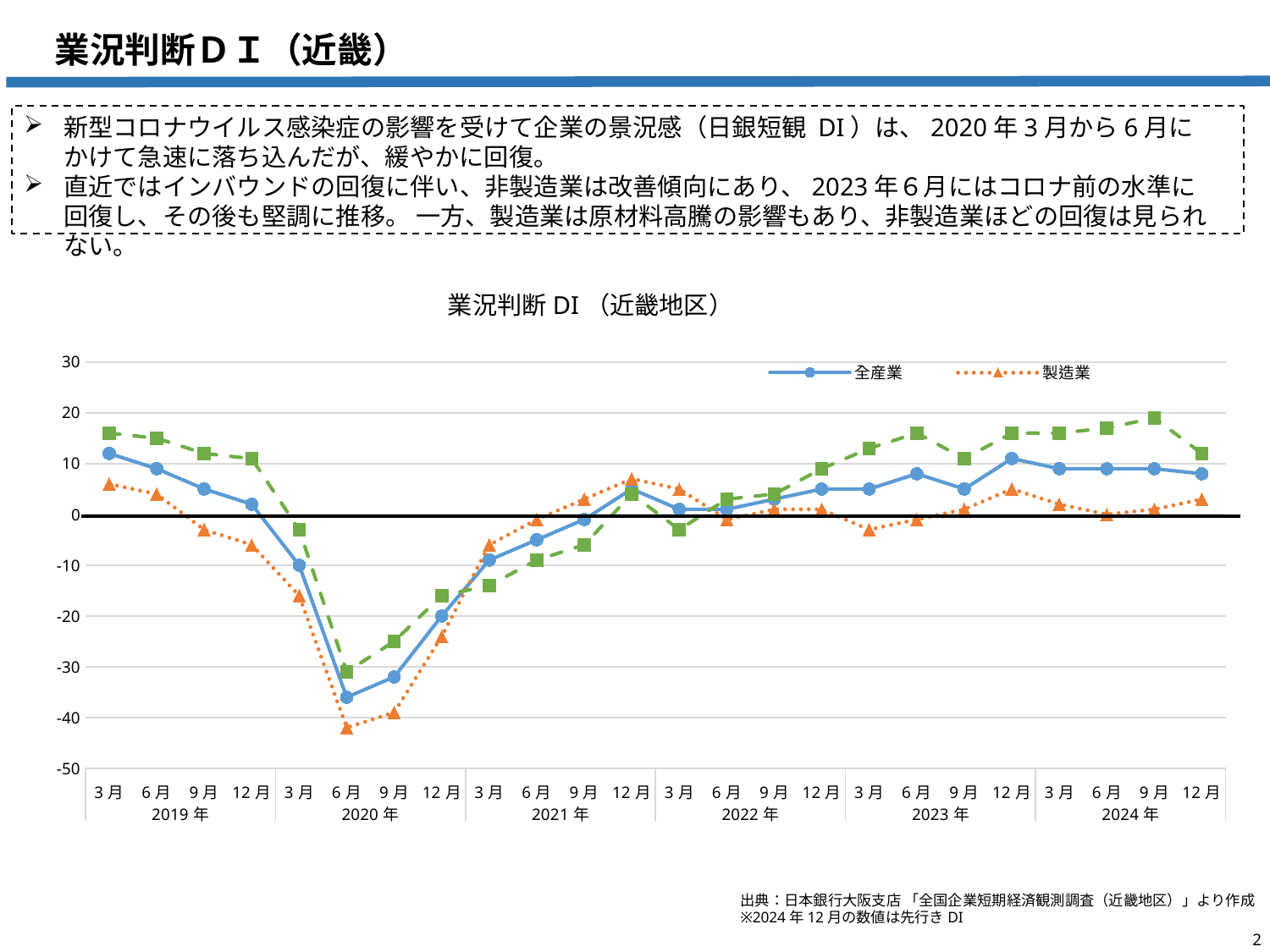
Is the value for 製造業 in 2020年6月 greater or less than -40? less Does the 全産業 series rise or fall between 2020年3月 and 2020年6月? fall Is the value for 全産業 in 2019年3月 greater or less than 10? greater What kind of chart is shown on the slide? line chart How many series does the chart's legend list? 2 Which series are named in the chart's legend? 全産業, 製造業 Is the value for 全産業 in 2020年6月 greater or less than -30? less What is the title of the chart? 業況判断DI（近畿地区） In which month and year does the 全産業 series reach its lowest value? 2020年6月 In which month and year does the 製造業 series reach its lowest value? 2020年6月 How many data points does each series have along the x axis? 24 In 2019年3月, which series has the higher value, 全産業 or 製造業? 全産業